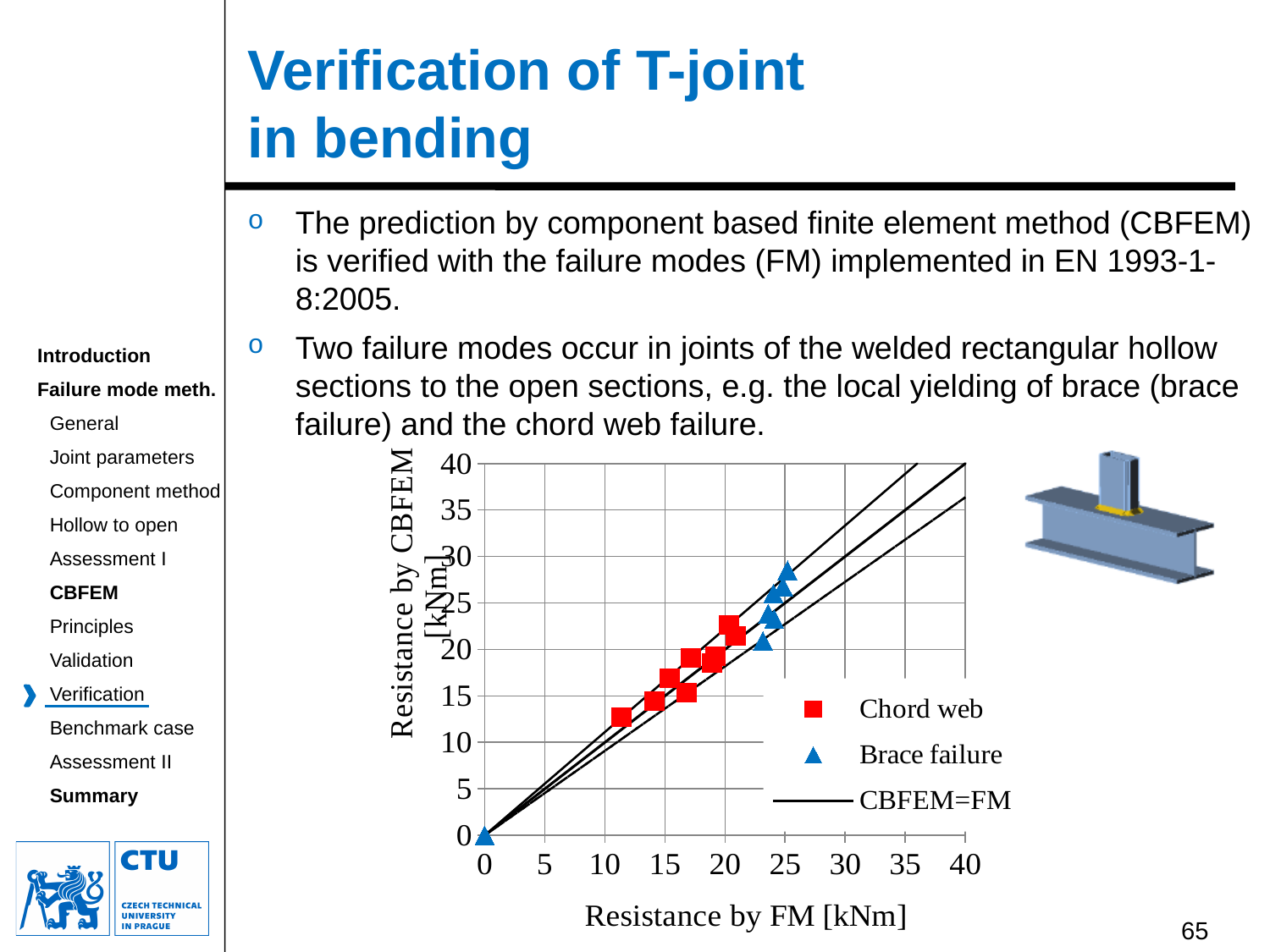
What is the title of the vertical axis of the chart? Resistance by CBFEM [kNm] Which legend entry is shown with red square markers? Chord web Do the plotted points rise or fall as Resistance by FM increases? Rise How many entries does the chart legend list? 3 What is the maximum value shown on the vertical axis of the chart? 40 Which legend entry is shown with blue triangle markers? Brace failure Which series has points with higher Resistance by FM values, Chord web or Brace failure? Brace failure Is the lowest Chord web point's Resistance by FM greater or less than 15? less What is the maximum value shown on the horizontal axis of the chart? 40 What is the title of the horizontal axis of the chart? Resistance by FM [kNm] What kind of chart is shown on the slide? Scatter chart Is the highest Brace failure point's Resistance by CBFEM greater or less than 20? greater